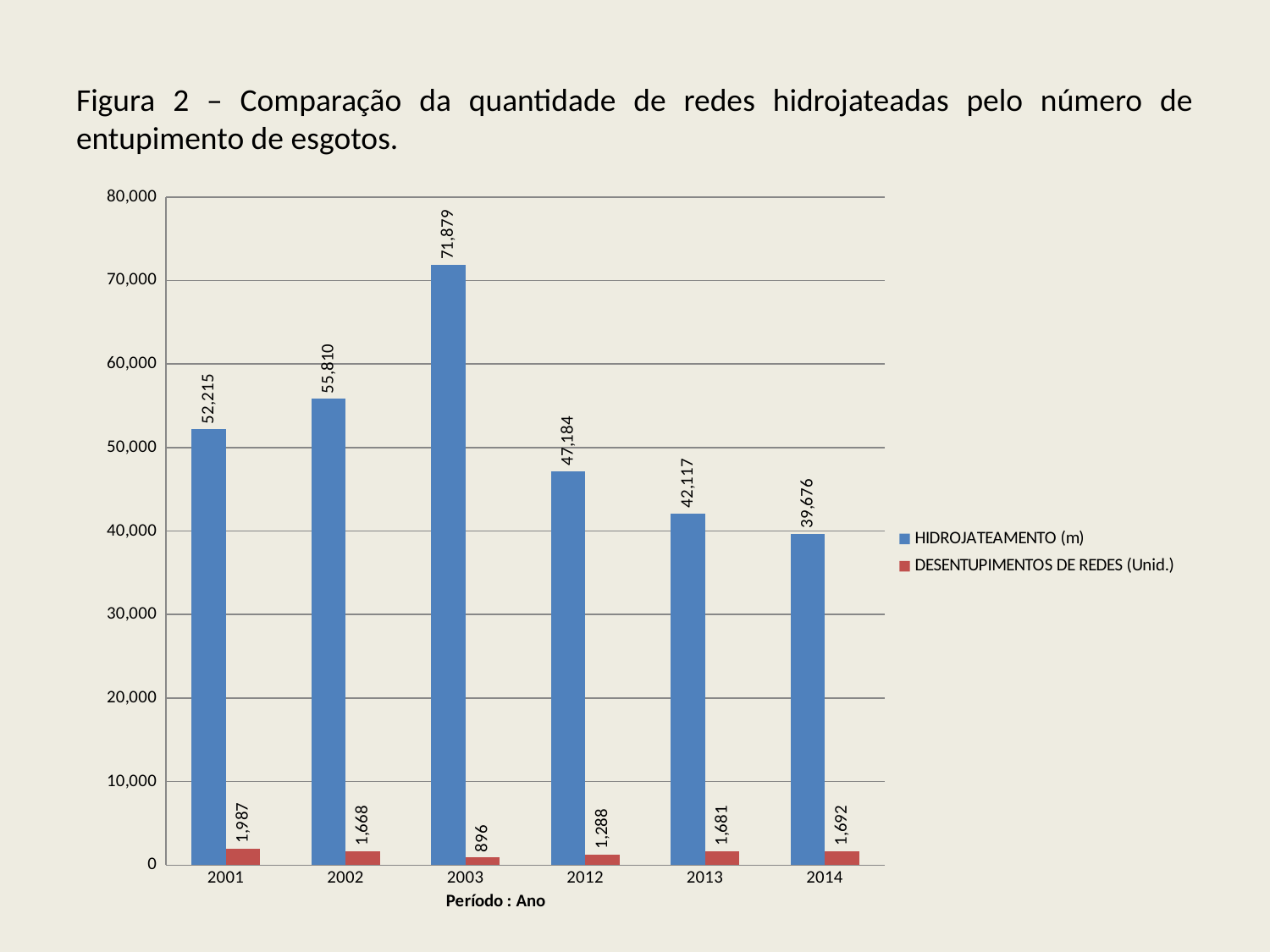
What kind of chart is shown on the slide? bar chart What is the HIDROJATEAMENTO (m) value for 2014? 39,676 What is the DESENTUPIMENTOS DE REDES (Unid.) value for 2001? 1,987 What is the difference between the HIDROJATEAMENTO (m) values for 2002 and 2001? 3,595 Which year has the highest HIDROJATEAMENTO (m) value? 2003 How many years are shown on the x axis? 6 Which year has the lowest DESENTUPIMENTOS DE REDES (Unid.) value? 2003 What is the x-axis title of the chart? Período : Ano How many series does the legend list? 2 Which is larger, the DESENTUPIMENTOS DE REDES (Unid.) value for 2013 or for 2014? 2014 What is the HIDROJATEAMENTO (m) value for 2003? 71,879 Is the HIDROJATEAMENTO (m) value for 2012 greater or less than 50,000? less